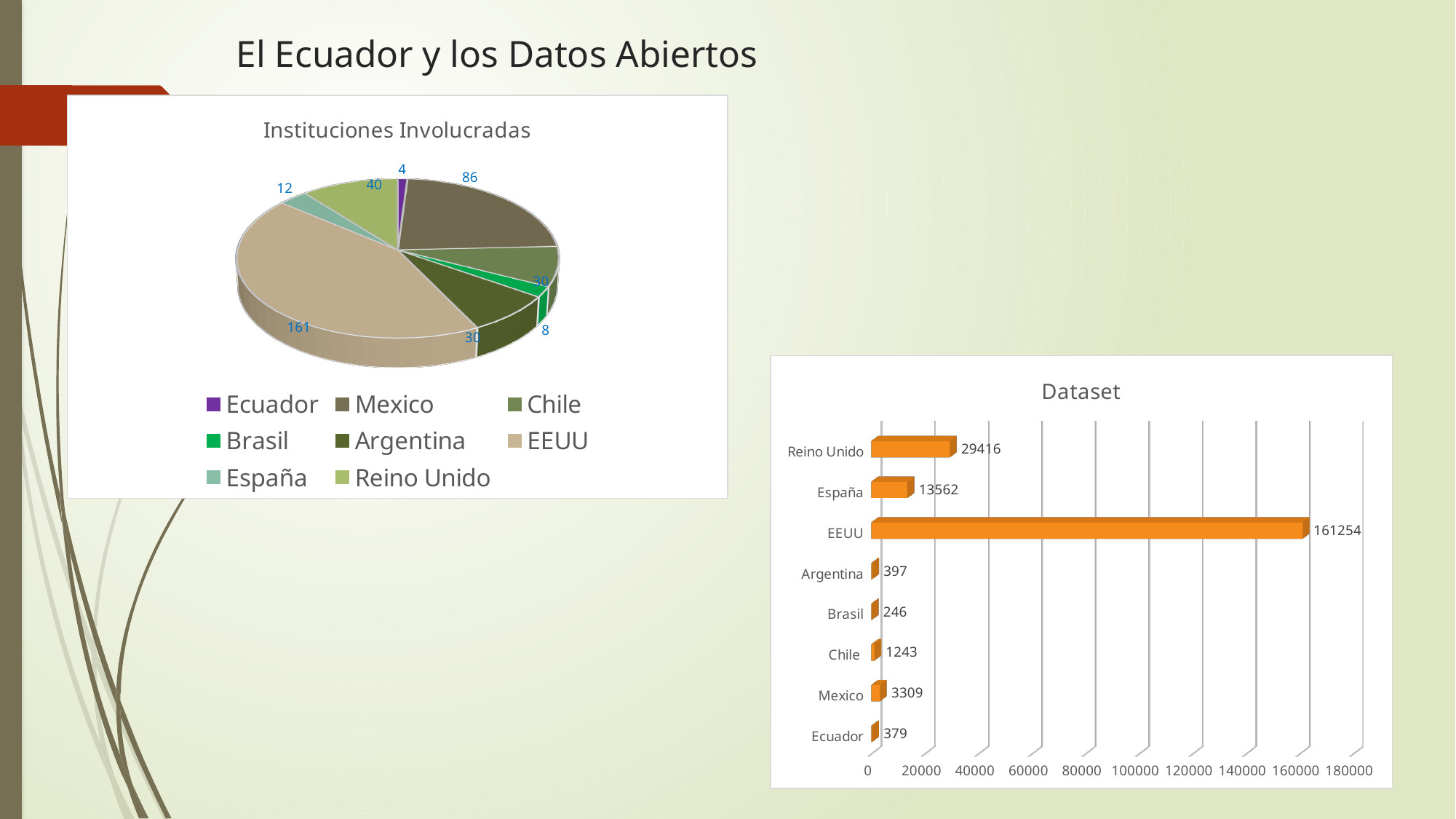
What kind of chart is 'Dataset'? Bar chart In the 'Dataset' chart, what is the value for Chile? 1243 In the 'Instituciones Involucradas' chart, which category has the smallest slice? Ecuador In the 'Instituciones Involucradas' chart, what is the value for EEUU? 161 In the 'Instituciones Involucradas' chart, how many categories does the legend list? 8 In the 'Instituciones Involucradas' chart, what is the value for Mexico? 86 In the 'Dataset' chart, which category has the highest value? EEUU In the 'Instituciones Involucradas' chart, what is the difference between the values for Reino Unido and España? 28 In the 'Dataset' chart, what is the value for Reino Unido? 29416 In the 'Dataset' chart, which is larger, the value for Mexico or the value for Ecuador? Mexico In the 'Dataset' chart, which category has the lowest value? Brasil What kind of chart is 'Instituciones Involucradas'? Pie chart